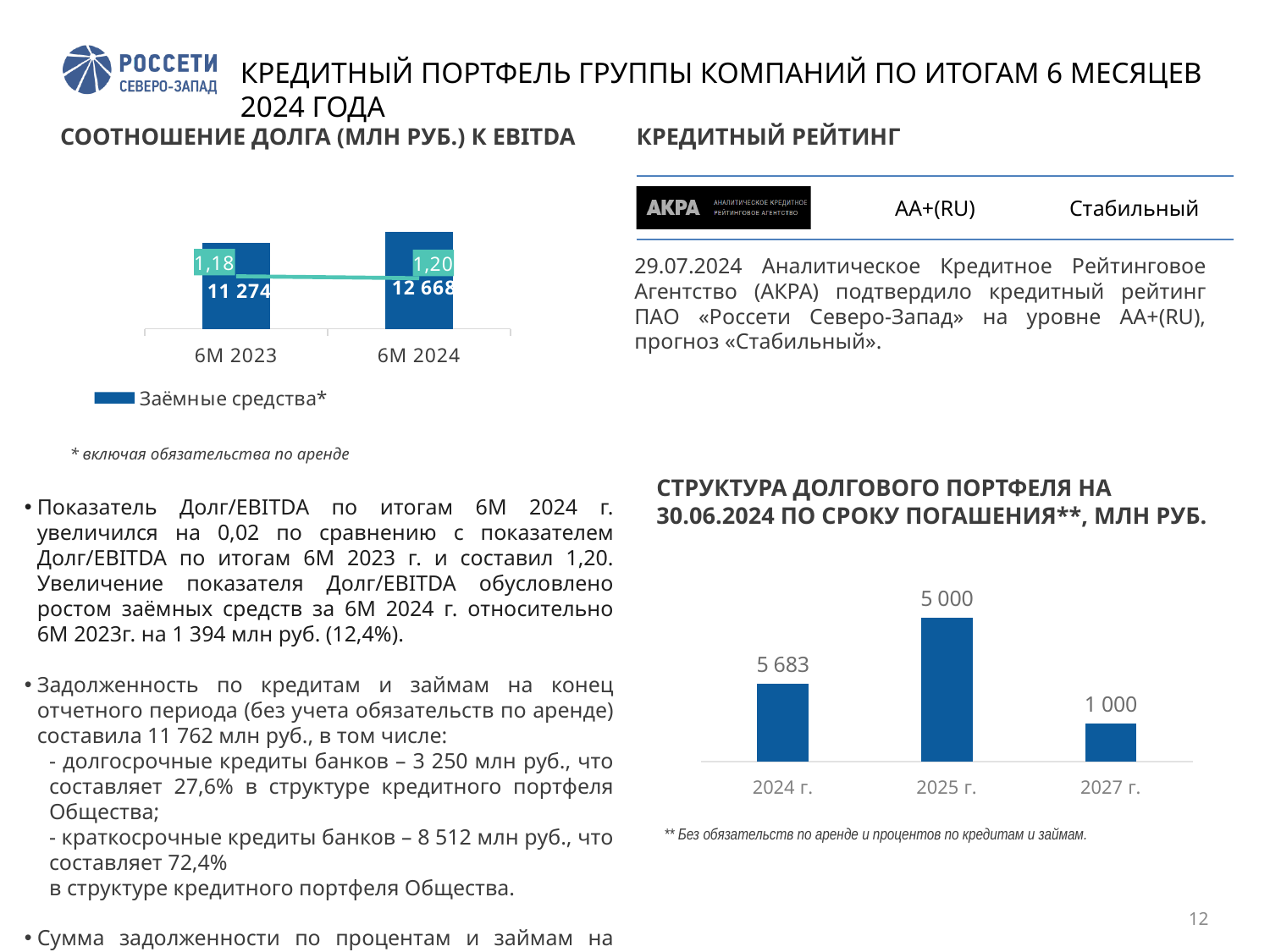
On the chart 'Соотношение долга (млн руб.) к EBITDA', what is the Долг/EBITDA ratio shown for 6М 2023? 1,18 On the chart 'Соотношение долга (млн руб.) к EBITDA', what series name is listed in the legend? Заёмные средства* On the chart 'Соотношение долга (млн руб.) к EBITDA', do the values of Заёмные средства* rise or fall from 6М 2023 to 6М 2024? rise On the chart 'Соотношение долга (млн руб.) к EBITDA', what is the value of Заёмные средства* for 6М 2024? 12 668 On the chart 'Соотношение долга (млн руб.) к EBITDA', by how much did Заёмные средства* increase from 6М 2023 to 6М 2024? 1 394 On the chart 'Структура долгового портфеля на 30.06.2024 по сроку погашения**, млн руб.', what is the value for 2025 г.? 5 000 On the chart 'Соотношение долга (млн руб.) к EBITDA', what is the value of Заёмные средства* for 6М 2023? 11 274 On the chart 'Структура долгового портфеля на 30.06.2024 по сроку погашения**, млн руб.', how many years are shown on the x axis? 3 On the chart 'Структура долгового портфеля на 30.06.2024 по сроку погашения**, млн руб.', what is the difference between the values for 2024 г. and 2027 г.? 4 683 On the chart 'Соотношение долга (млн руб.) к EBITDA', what is the Долг/EBITDA ratio shown for 6М 2024? 1,20 On the chart 'Структура долгового портфеля на 30.06.2024 по сроку погашения**, млн руб.', which year has the lowest value? 2027 г.